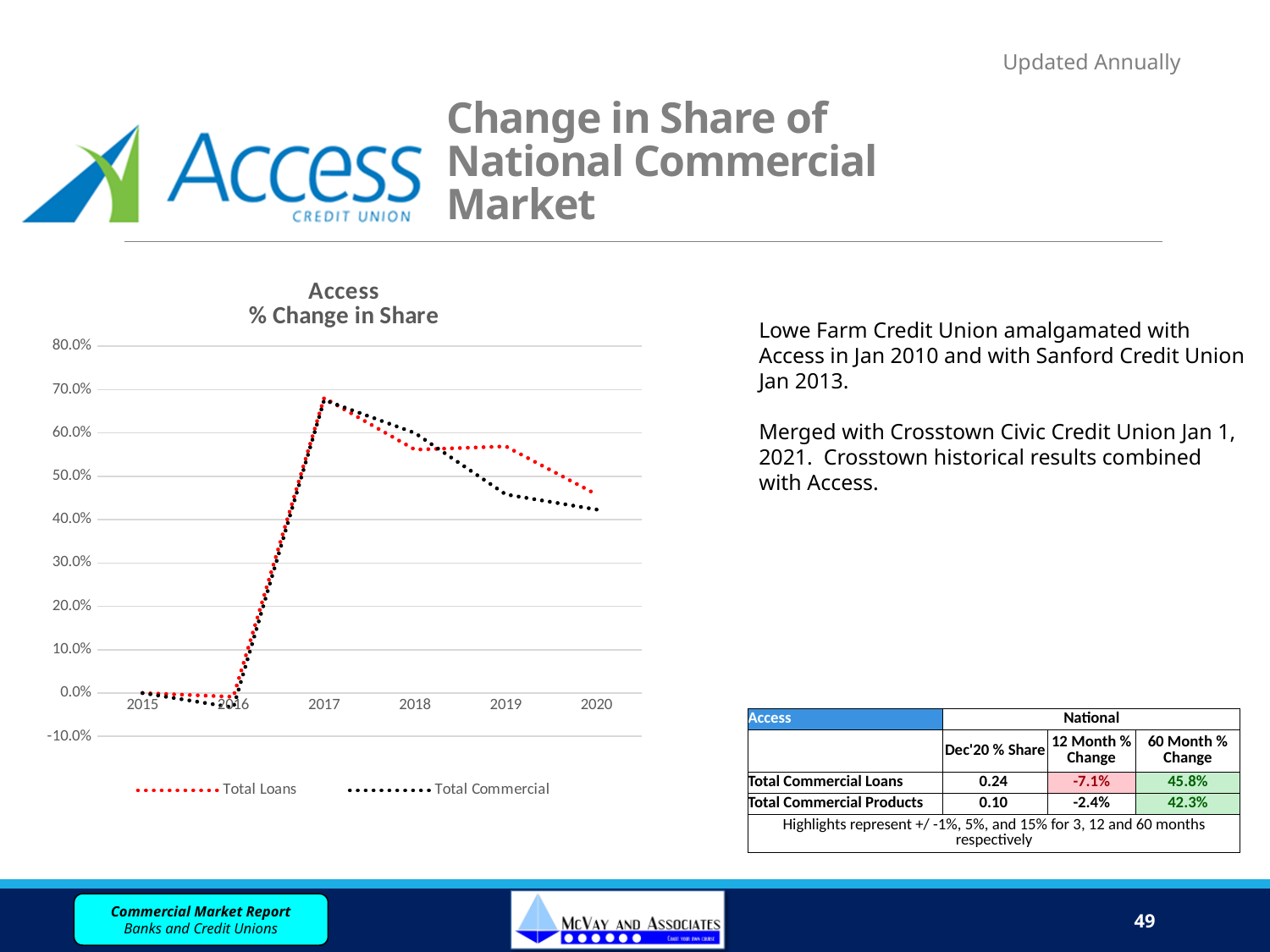
What kind of chart is the "Access % Change in Share" chart? line chart How many series does the legend of the "Access % Change in Share" chart list? 2 Is the value for Total Loans in 2017 greater or less than 60.0%? greater In 2019, which series has the higher value, Total Loans or Total Commercial? Total Loans Does the Total Commercial series rise or fall from 2017 to 2020? fall What colour is the Total Loans line in the chart? red In which year does the Total Loans series reach its highest value? 2017 Is the value for Total Commercial in 2019 greater or less than 50.0%? less How many years are shown on the x axis of the "Access % Change in Share" chart? 6 Does the Total Loans series rise or fall from 2016 to 2017? rise Is the value for Total Loans in 2016 greater or less than 10.0%? less